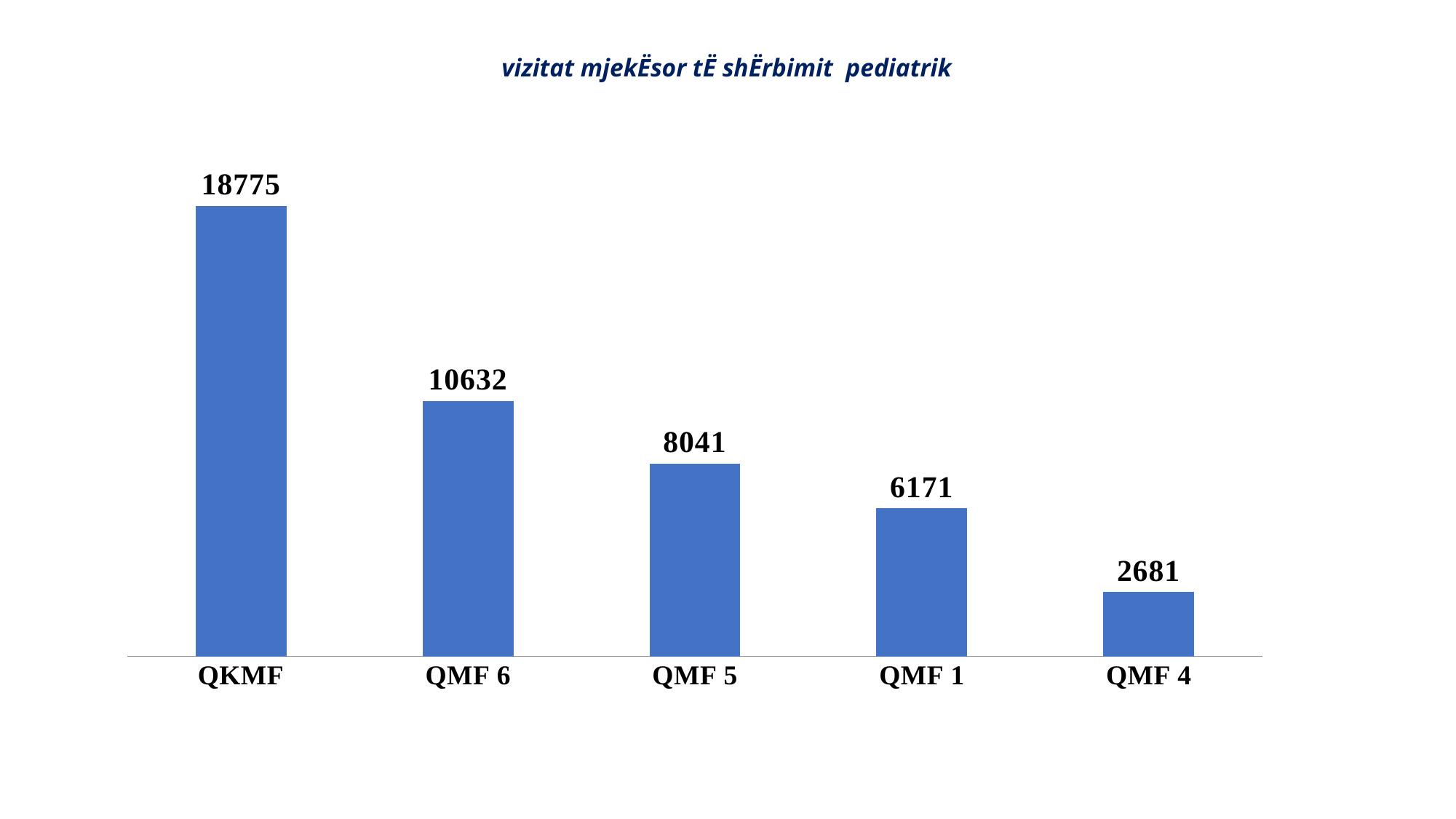
What is the value for QKMF? 18775 What is the value for QMF 1? 6171 What is the difference between the values for QMF 5 and QMF 1? 1870 What kind of chart is shown on the slide? Bar chart Which is larger, the value for QMF 1 or the value for QMF 4? QMF 1 Which category has the lowest value? QMF 4 What is the value for QMF 5? 8041 What is the value for QMF 6? 10632 Which category has the highest value? QKMF What is the value for QMF 4? 2681 What is the difference between the values for QKMF and QMF 6? 8143 How many categories are shown in the chart? 5